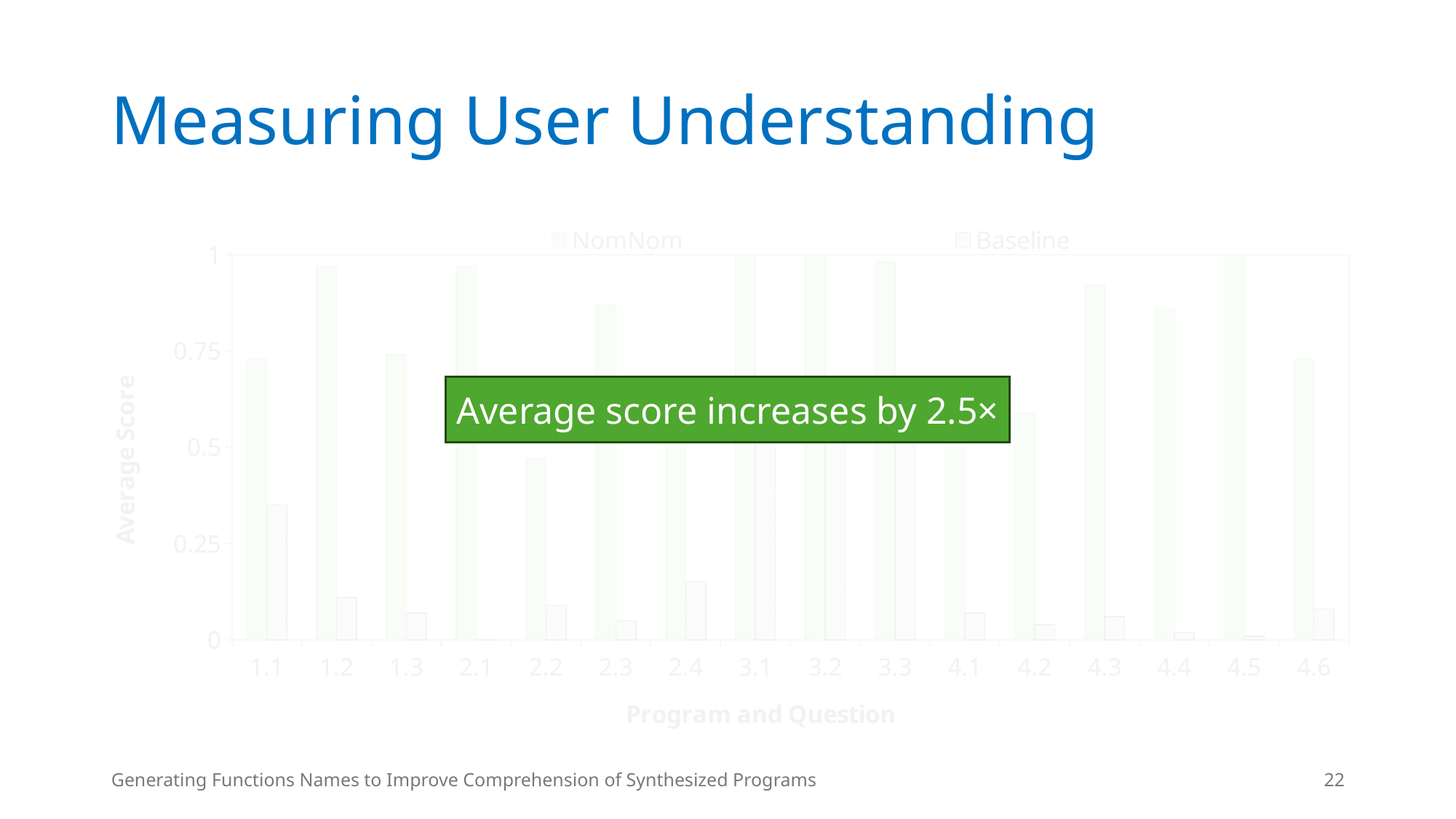
Is the NomNom value for 4.3 greater or less than 0.75? greater For category 1.1, which series has the larger value, NomNom or Baseline? NomNom Is the NomNom value for 1.2 greater or less than 0.75? greater How many series does the chart legend list? 2 Is the NomNom value for 1.1 greater or less than 0.5? greater What are the two series named in the legend? NomNom and Baseline What is the label of the y axis? Average Score How many program-and-question categories are shown on the x axis? 16 What kind of chart is shown on the slide? bar chart